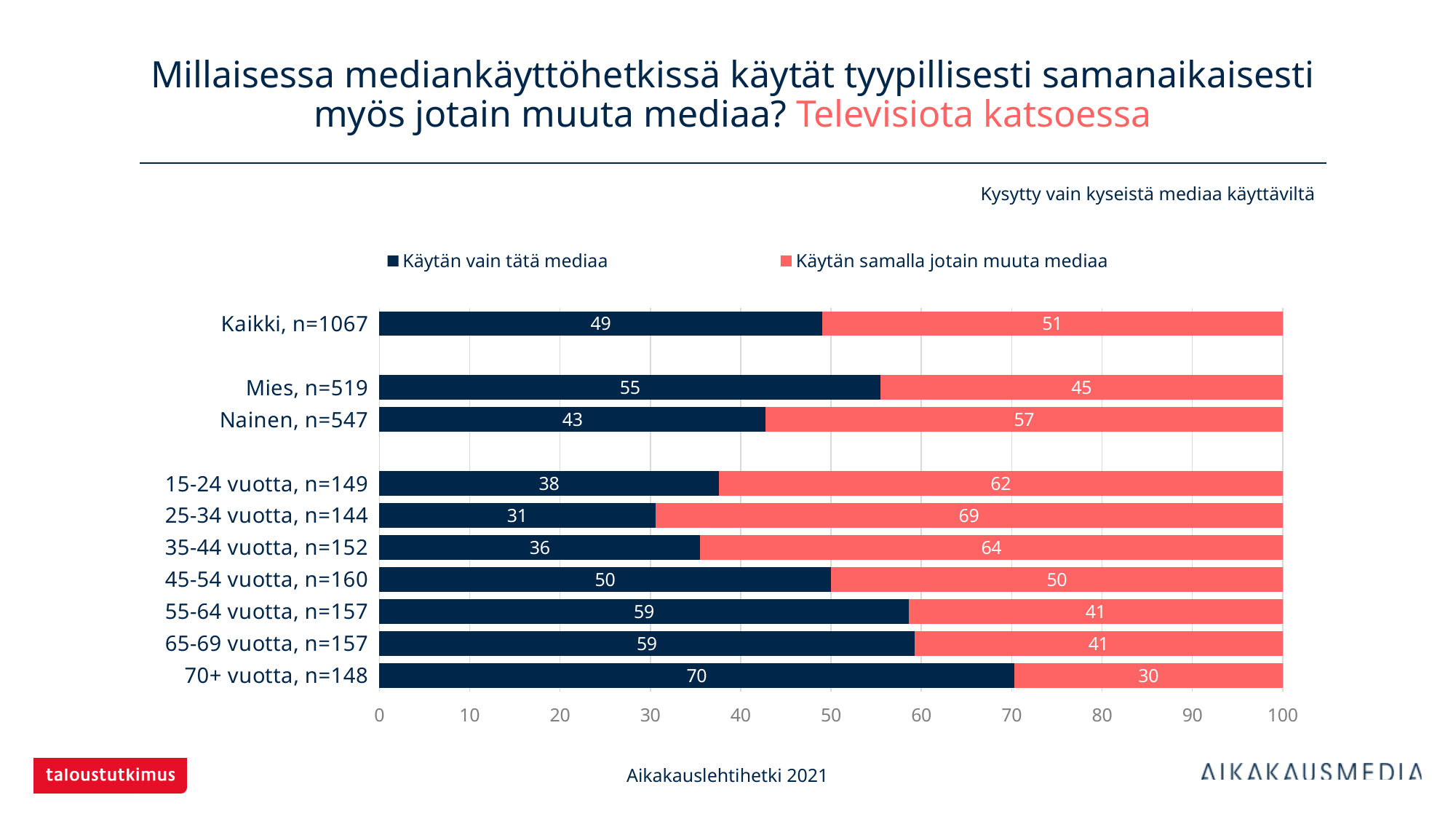
What colour represents the series "Käytän samalla jotain muuta mediaa"? red What kind of chart is shown on the slide? stacked bar chart How many series does the legend list? 2 Which has a larger "Käytän samalla jotain muuta mediaa" value: "15-24 vuotta, n=149" or "35-44 vuotta, n=152"? 35-44 vuotta, n=152 What is the value of "Käytän samalla jotain muuta mediaa" for "25-34 vuotta, n=144"? 69 What is the value of "Käytän vain tätä mediaa" for "Nainen, n=547"? 43 What is the total of the stacked bar for "45-54 vuotta, n=160"? 100 What is the difference between the "Käytän vain tätä mediaa" values for "Mies, n=519" and "Nainen, n=547"? 12 What is the value of "Käytän vain tätä mediaa" for "Kaikki, n=1067"? 49 How many categories are plotted on the chart? 10 Which category has the lowest value for "Käytän vain tätä mediaa"? 25-34 vuotta, n=144 Which category has the highest value for "Käytän vain tätä mediaa"? 70+ vuotta, n=148